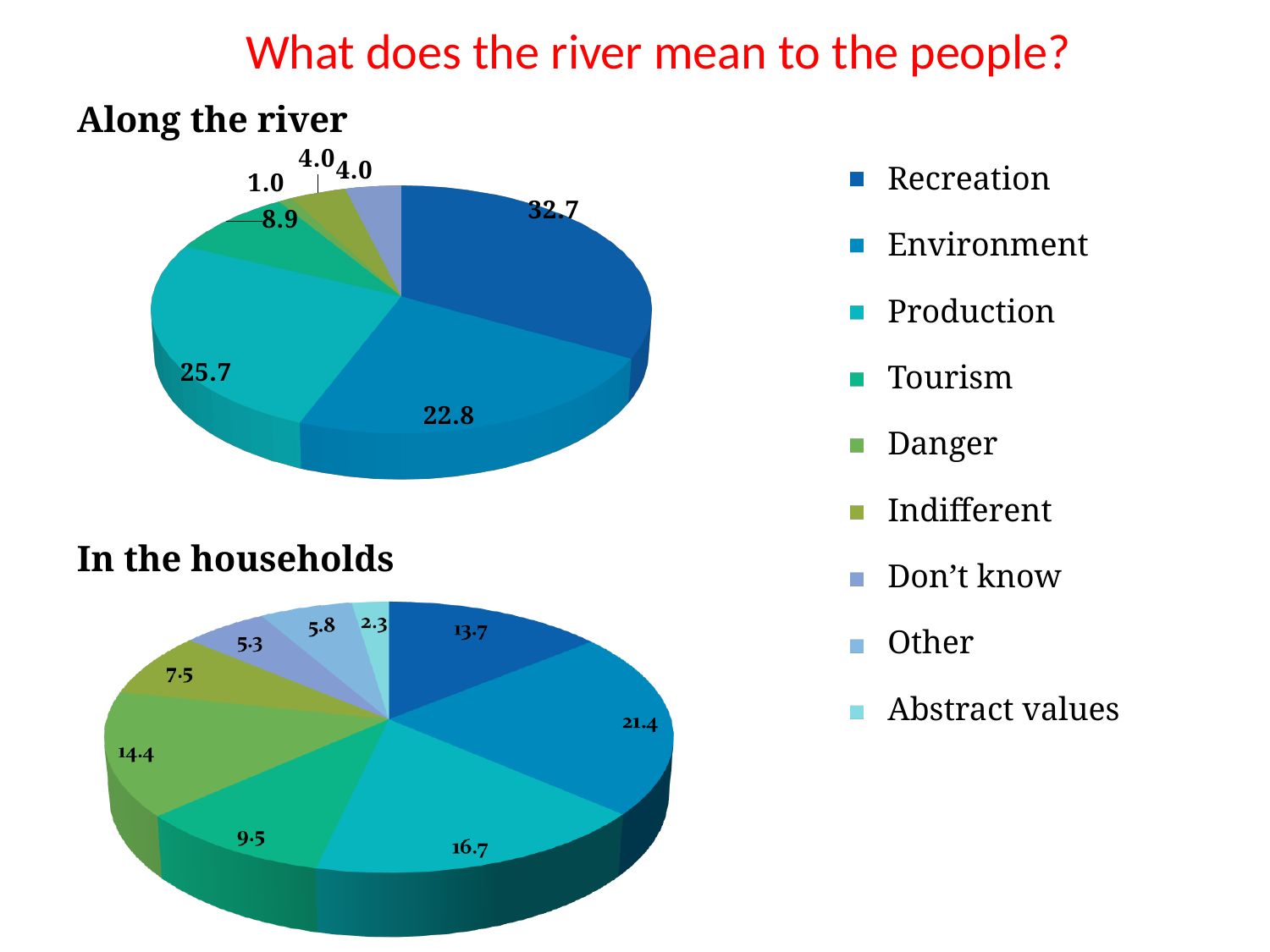
In the 'In the households' chart, which category has the smallest slice? Abstract values What type of charts are shown on the slide? Pie charts How many categories does the legend list? 9 In the 'Along the river' chart, what is the value for Recreation? 32.7 In the 'In the households' chart, what is the difference between Environment and Recreation? 7.7 In the 'In the households' chart, which category has the largest slice? Environment In the 'In the households' chart, what is the value for Danger? 14.4 In the 'Along the river' chart, which category has the largest slice? Recreation In the 'Along the river' chart, what is the difference between Recreation and Environment? 9.9 In the 'In the households' chart, which is larger, Production or Tourism? Production In the 'Along the river' chart, what is the value for Production? 25.7 In the 'In the households' chart, what is the value for Environment? 21.4